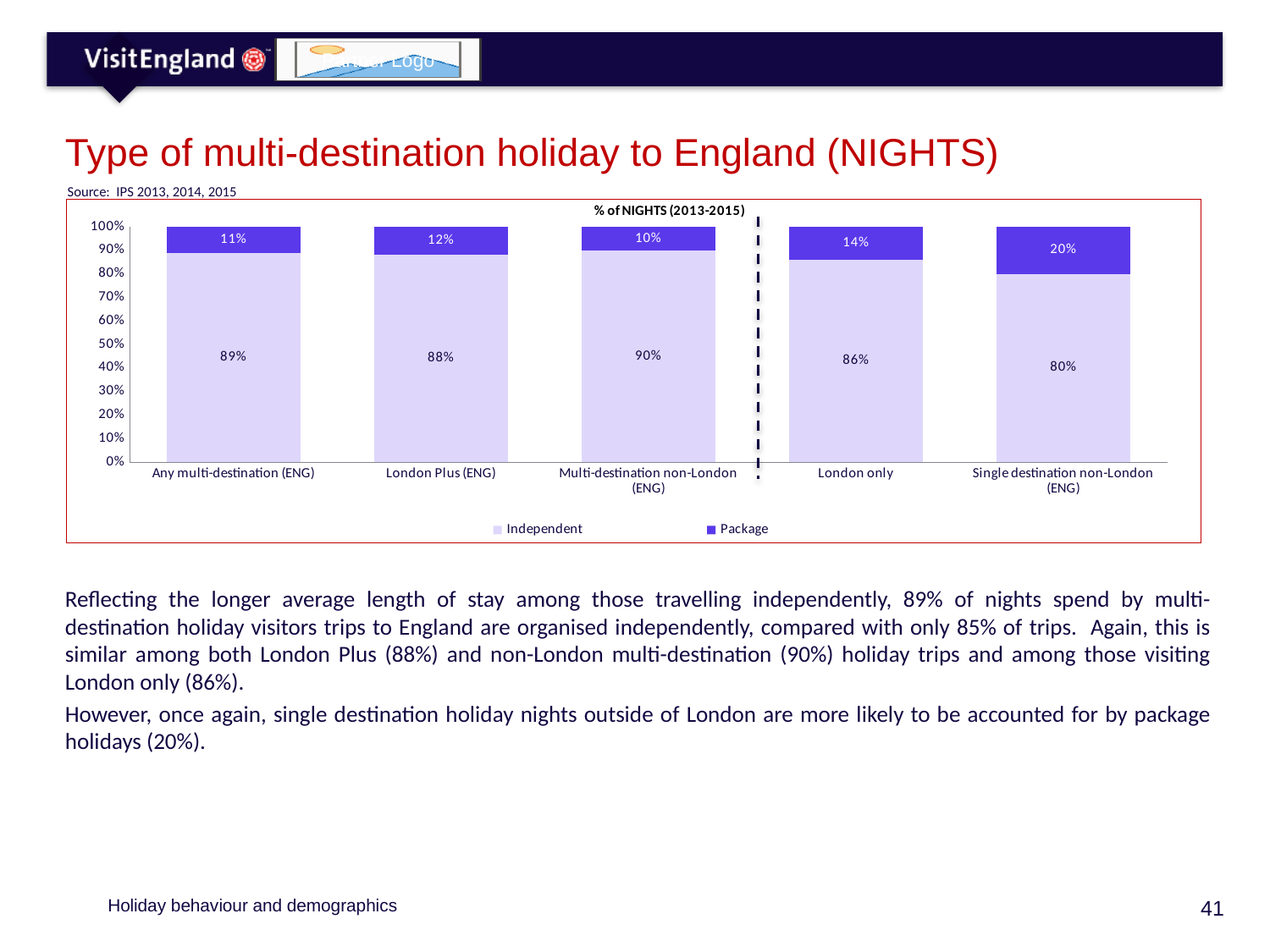
What is the Package share of nights for London only? 14% How many series does the legend list? 2 What kind of chart is shown on the slide? Stacked bar chart Which category has the lowest Package share of nights? Multi-destination non-London (ENG) Which has a larger Package share of nights, London only or London Plus (ENG)? London only What is the Independent share of nights for Multi-destination non-London (ENG)? 90% What is the Package share of nights for Single destination non-London (ENG)? 20% Which category has the highest Package share of nights? Single destination non-London (ENG) What is the difference between the Independent share for Any multi-destination (ENG) and Single destination non-London (ENG)? 9 percentage points How many categories are shown on the x axis of the chart? 5 What is the title of the chart? % of NIGHTS (2013-2015) What is the Independent share of nights for London Plus (ENG)? 88%